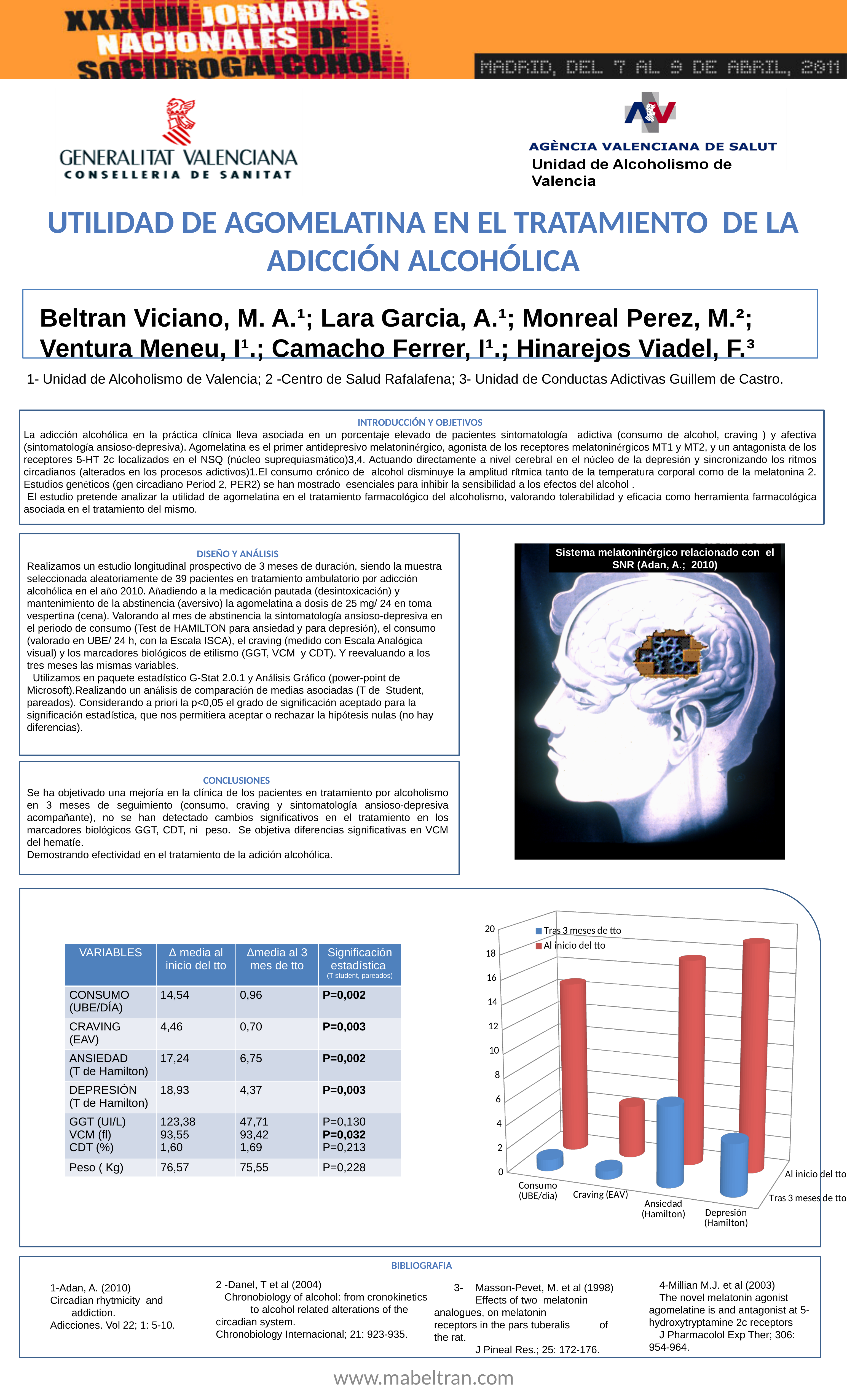
What kind of chart is shown on the slide? bar chart Is the 'Tras 3 meses de tto' value for Consumo (UBE/dia) greater or less than 4? less How many categories are plotted along the x axis of the chart? 4 For Depresión (Hamilton), which series has the larger value: 'Al inicio del tto' or 'Tras 3 meses de tto'? Al inicio del tto How many series does the chart legend list? 2 Which category has the highest value for the 'Tras 3 meses de tto' series? Ansiedad (Hamilton) Is the 'Al inicio del tto' value for Craving (EAV) greater or less than 8? less Is the 'Al inicio del tto' value for Consumo (UBE/dia) greater or less than 10? greater Which category has the highest value for the 'Al inicio del tto' series? Depresión (Hamilton) Which category has the lowest value for the 'Al inicio del tto' series? Craving (EAV) What colour are the bars for the 'Al inicio del tto' series? red